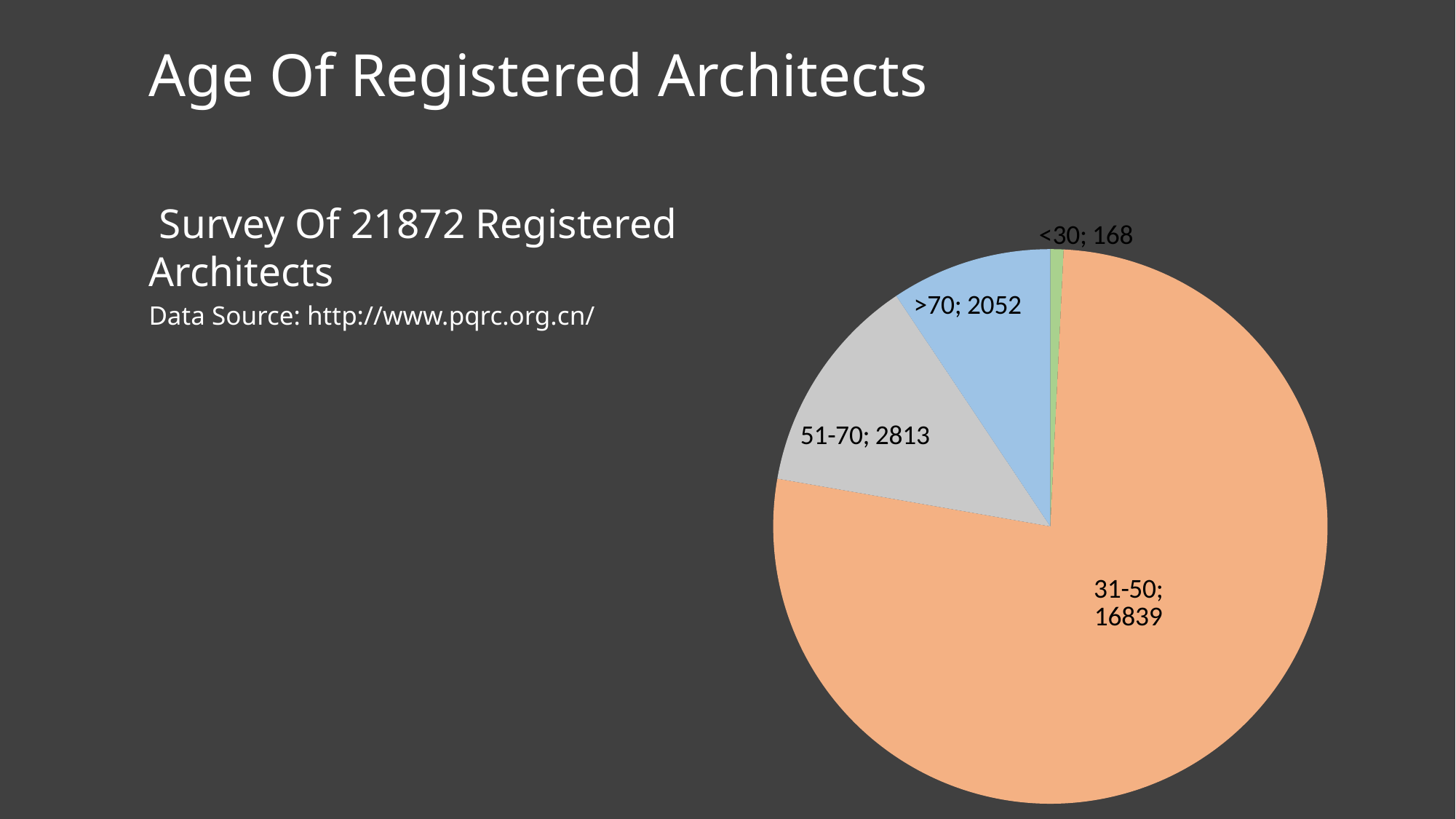
What is the difference between the 31-50 and 51-70 age groups? 14026 What type of chart is shown on the slide? pie chart What is the value shown for the 51-70 age group? 2813 How many registered architects are in the 31-50 age group? 16839 Which age group has the smallest slice of the pie? <30 Which is larger, the >70 group or the 51-70 group? 51-70 What is the difference between the 51-70 and >70 age groups? 761 What is the value shown for the <30 age group? 168 How many age groups are shown in the pie chart? 4 What is the total of all four slices in the pie chart? 21872 Which age group has the largest slice of the pie? 31-50 What is the value shown for the >70 age group? 2052